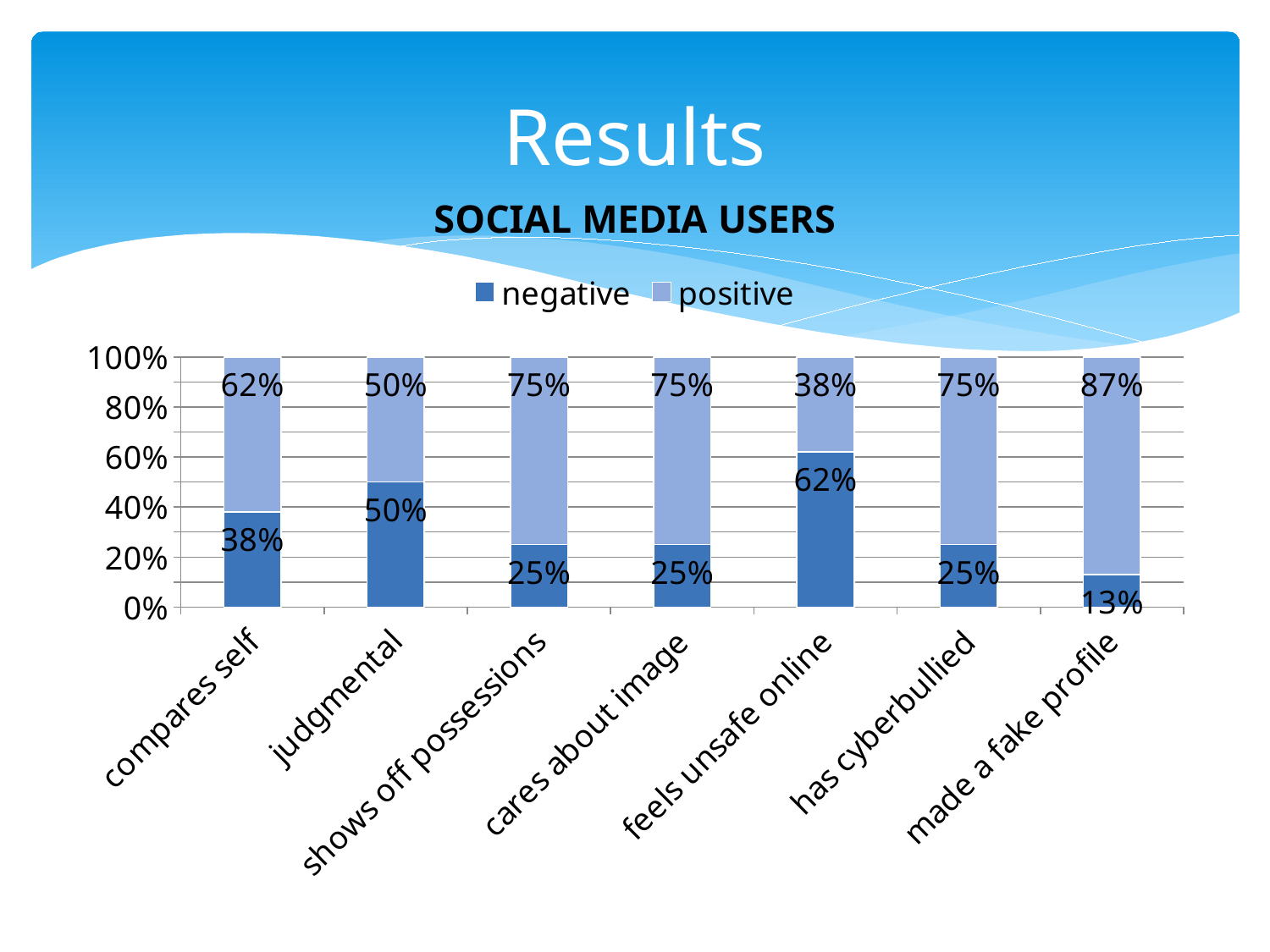
What is the positive value for 'made a fake profile'? 87% Which category has the lowest negative value? made a fake profile Which category has the highest negative value? feels unsafe online Which series is shown in the darker blue colour? negative What is the negative value for 'judgmental'? 50% How many categories are shown on the x axis? 7 Is the negative value larger for 'compares self' or for 'has cyberbullied'? compares self What kind of chart is shown? stacked bar chart What is the difference between the positive and negative values for 'compares self'? 24% How many series does the legend list? 2 What is the negative value for 'feels unsafe online'? 62% What is the title of the chart? SOCIAL MEDIA USERS